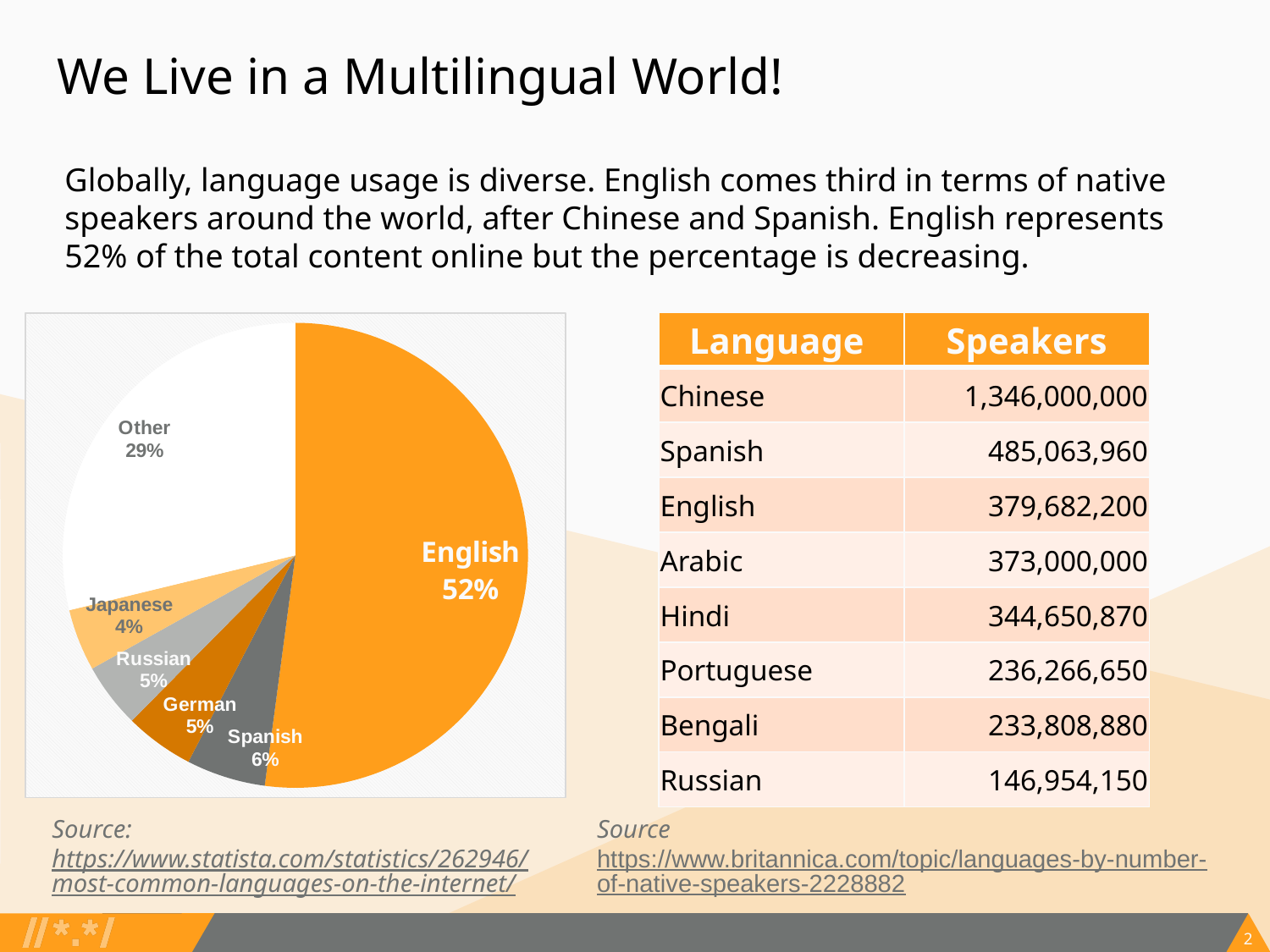
In the pie chart, which slice is the smallest? Japanese What kind of chart is shown on the left of the slide? Pie chart In the pie chart, how many slices are there? 6 In the pie chart, what share does Spanish have? 6% In the pie chart, what share does English have? 52% In the pie chart, what is the difference in percentage points between English and Other? 23 In the pie chart, what colour is the English slice? Orange In the pie chart, what share does Japanese have? 4% In the pie chart, which slice is the largest? English In the pie chart, what share does Other have? 29% In the pie chart, which is larger, Spanish or Japanese? Spanish In the pie chart, what share does Russian have? 5%